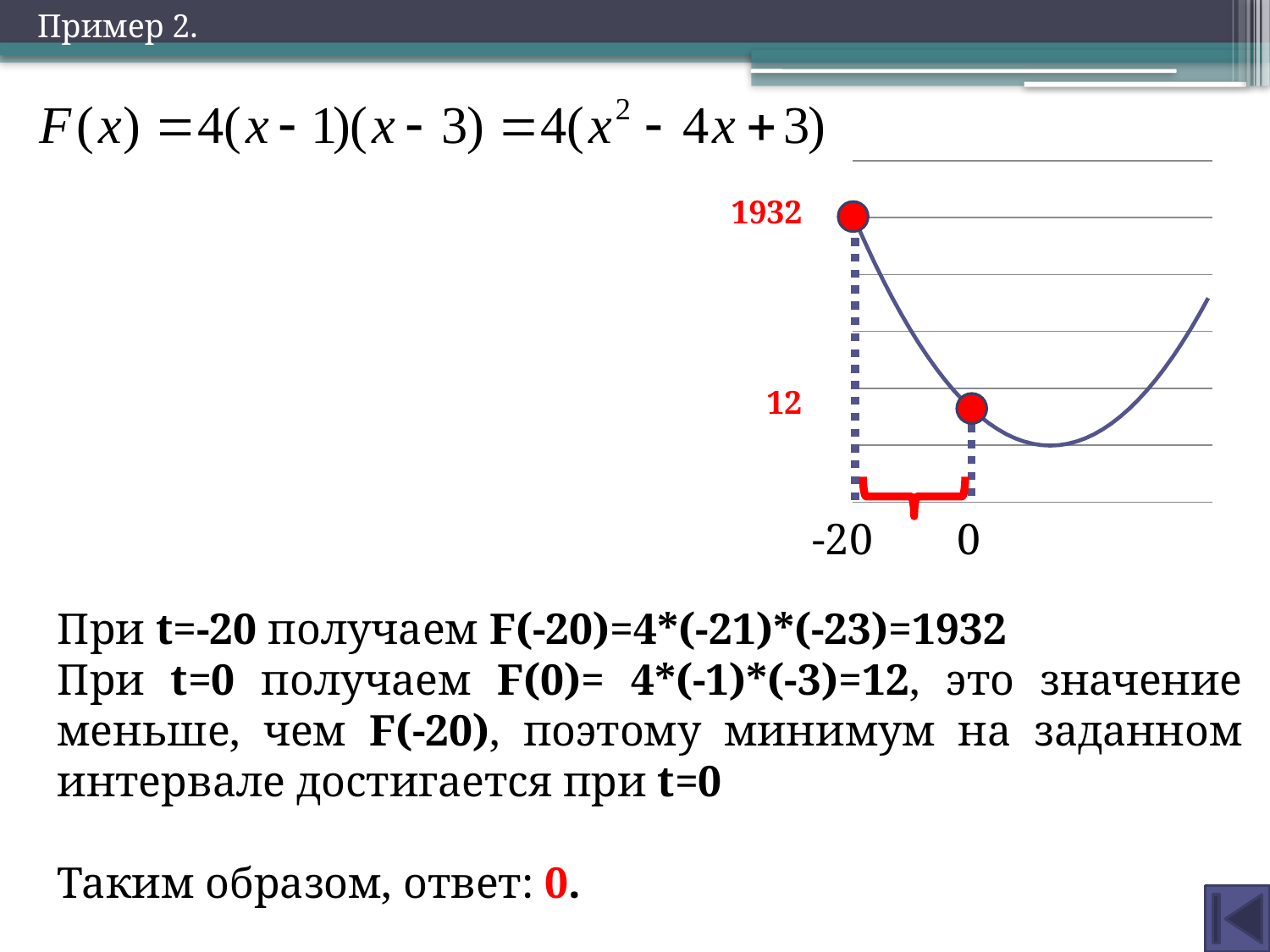
At which marked x value is the function value lowest? 0 What two x values are labelled on the horizontal axis of the chart? -20 and 0 How many points are marked with red dots on the chart? 2 Which of the two marked points on the chart has the larger value, x = -20 or x = 0? x = -20 What is the difference between the labelled values at x = -20 and x = 0? 1920 Does the curve rise or fall as x goes from -20 to 0? fall What is the value of the function at x = 0 according to the chart label? 12 At which marked x value is the function value highest? -20 What colour are the marked points on the chart? red What kind of chart is shown on the slide? line chart What is the value of the function at x = -20 according to the chart label? 1932